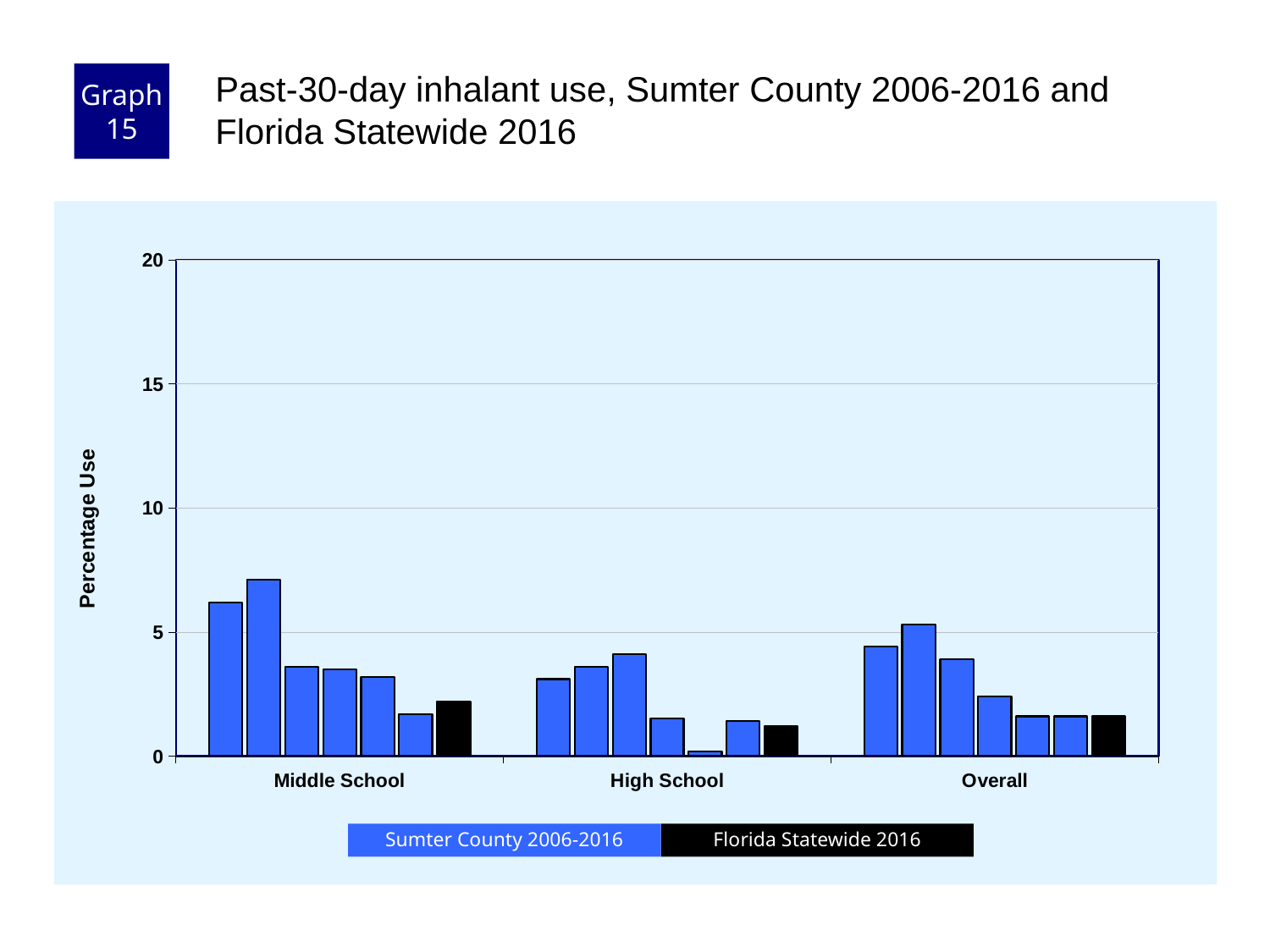
What kind of chart is shown on the slide? bar chart What is the label of the y axis? Percentage Use How many category groups are shown on the x axis? 3 Is any bar on the chart greater than 10? no In the Middle School group, is the last Sumter County bar higher or lower than the first Sumter County bar? lower Is the Florida Statewide 2016 value for Middle School greater or less than 5? less Is the tallest Sumter County bar in the Middle School group greater or less than 5? greater Is the Florida Statewide 2016 bar larger for Middle School or for High School? Middle School How many series does the legend list? 2 Which colour represents Florida Statewide 2016 in the legend? black Which category group contains the tallest bar on the chart? Middle School